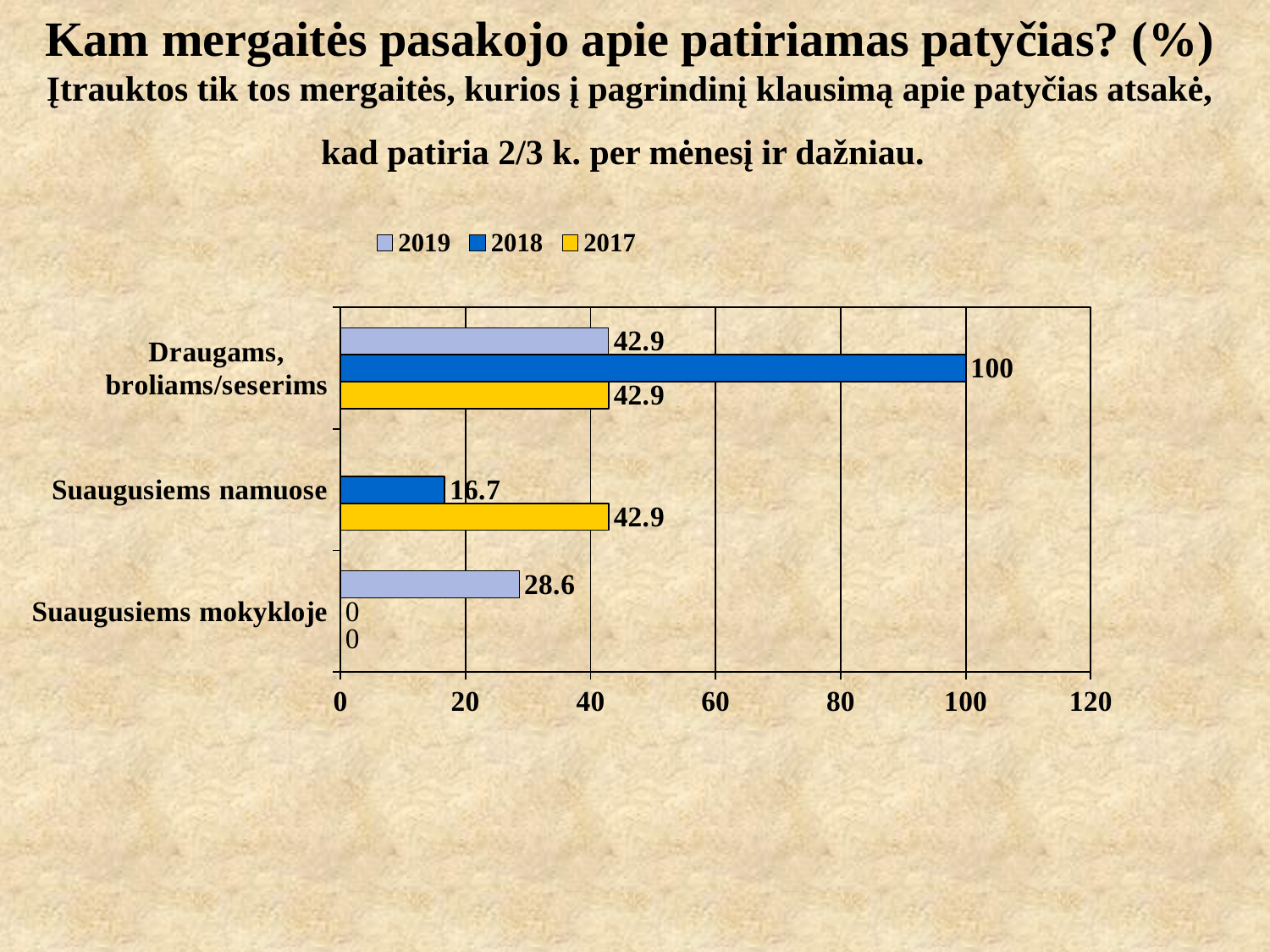
What is the difference between the 2018 and 2019 values for Draugams, broliams/seserims? 57.1 What kind of chart is shown on the slide? Bar chart What is the 2018 value for Suaugusiems namuose? 16.7 Which category has the highest 2018 value? Draugams, broliams/seserims Which category has the lowest 2017 value? Suaugusiems mokykloje What is the 2019 value for Suaugusiems mokykloje? 28.6 What is the 2018 value for Draugams, broliams/seserims? 100 How many series does the legend list? 3 What is the 2017 value for Suaugusiems namuose? 42.9 How many categories are shown on the chart? 3 Which is larger for Suaugusiems namuose: the 2018 value or the 2017 value? 2017 What is the 2018 value for Suaugusiems mokykloje? 0